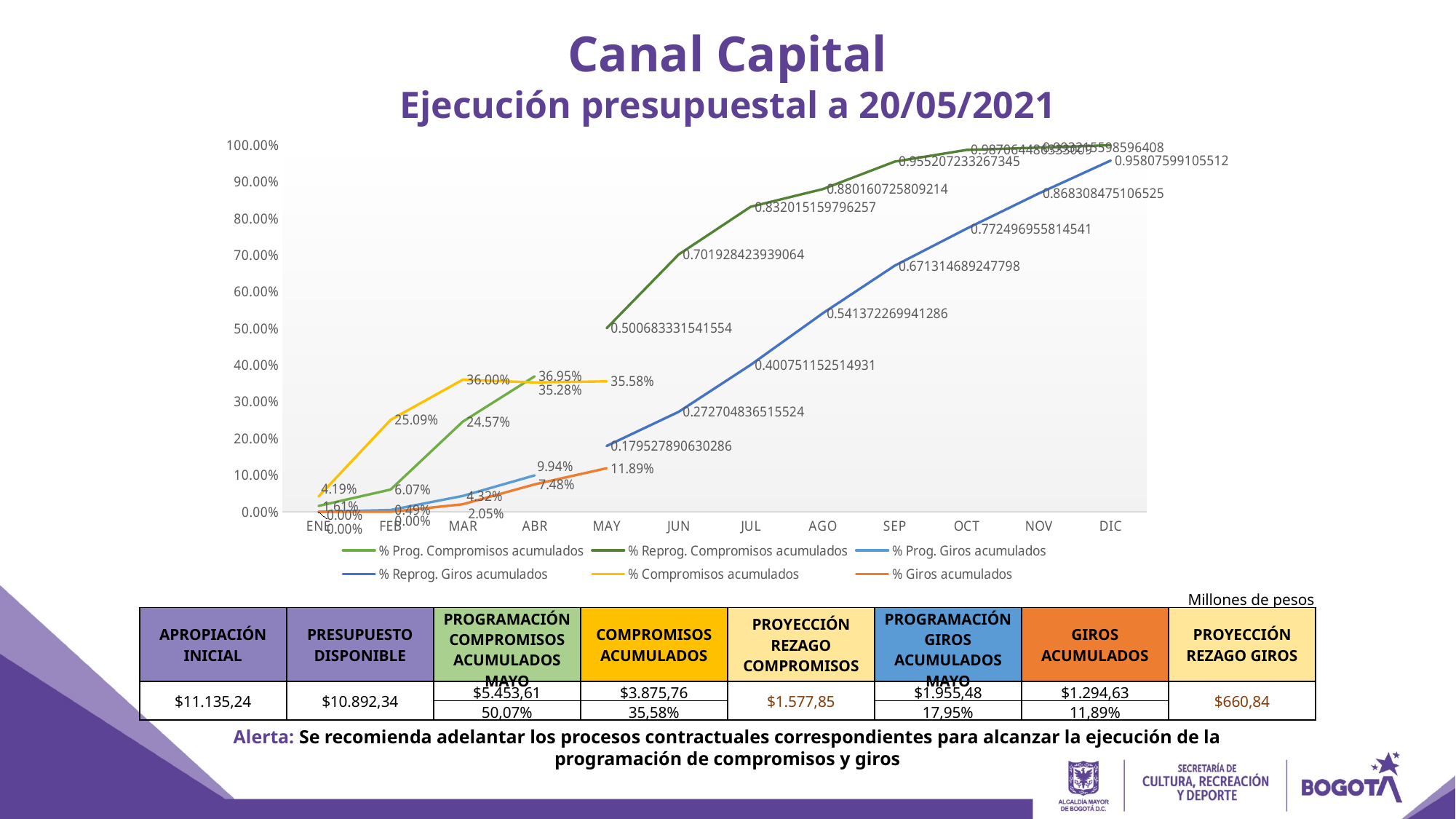
What is the value of % Prog. Compromisos acumulados in MAR? 24.57% What is the difference between % Compromisos acumulados and % Giros acumulados in MAY? 23.69% Is the value of % Reprog. Compromisos acumulados in SEP greater or less than 90.00%? greater How many months are shown along the x axis of the chart? 12 What is the value of % Giros acumulados in MAY? 11.89% What is the value of % Compromisos acumulados in MAY? 35.58% What is the value of % Reprog. Giros acumulados in DIC? 0.95807599105512 In MAY, which is larger: % Compromisos acumulados or % Giros acumulados? % Compromisos acumulados What kind of chart is shown on the slide? line chart Does the % Reprog. Giros acumulados line rise or fall from MAY to DIC? rises What is the value of % Reprog. Compromisos acumulados in JUN? 0.701928423939064 How many series does the chart legend list? 6